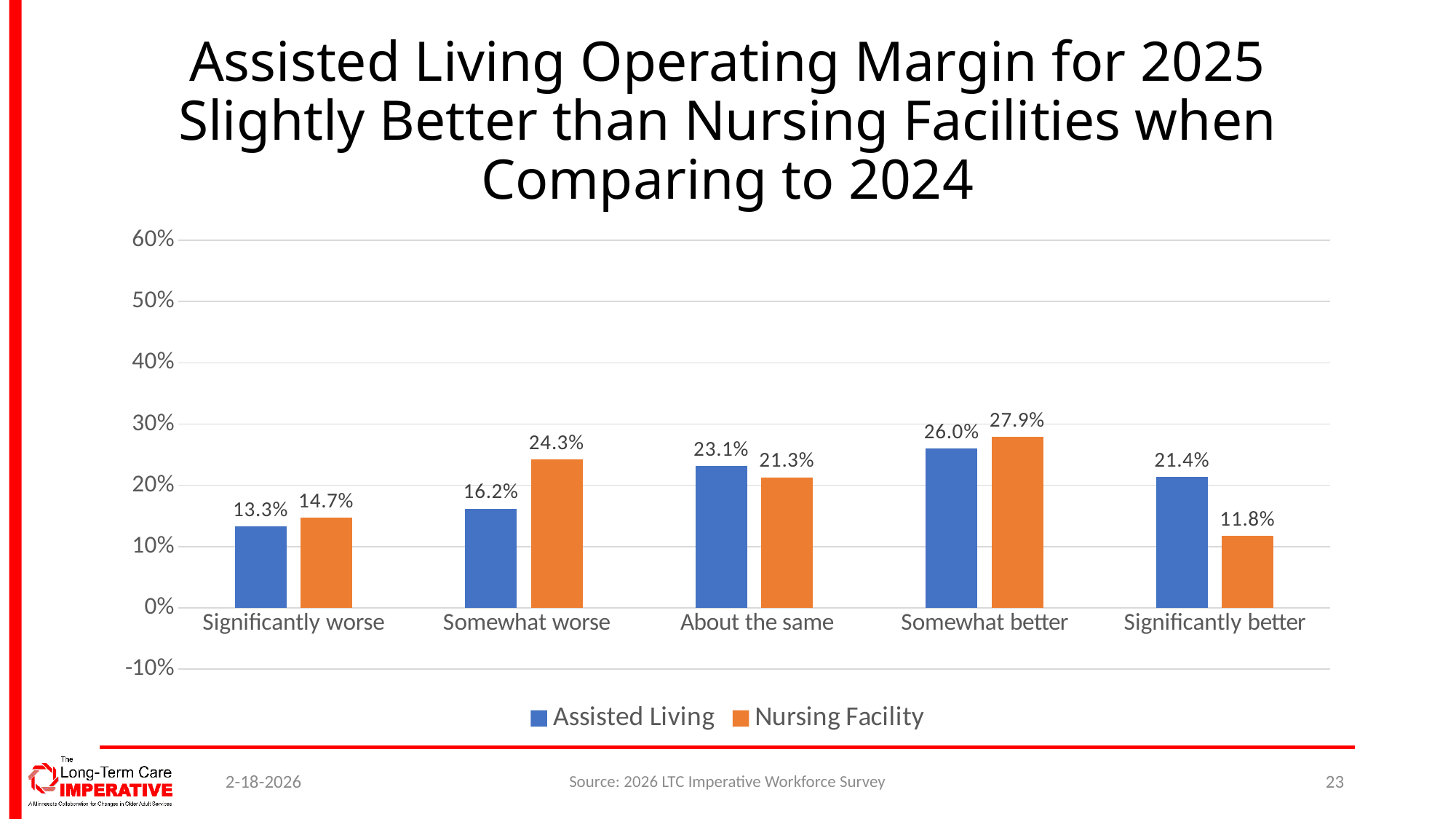
What is the Assisted Living value for "About the same"? 23.1% What is the difference between the Nursing Facility and Assisted Living values for "Somewhat worse"? 8.1% For "About the same", which series has the larger value, Assisted Living or Nursing Facility? Assisted Living What is the difference between the Assisted Living and Nursing Facility values for "Significantly better"? 9.6% Which category has the highest Nursing Facility value? Somewhat better What kind of chart is shown on the slide? Bar chart Which category has the lowest Assisted Living value? Significantly worse What is the Nursing Facility value for "Significantly better"? 11.8% What is the Nursing Facility value for "Somewhat worse"? 24.3% Is the Assisted Living value for "Somewhat better" greater or less than 20%? greater How many categories are shown on the x axis? 5 How many series does the legend list? 2